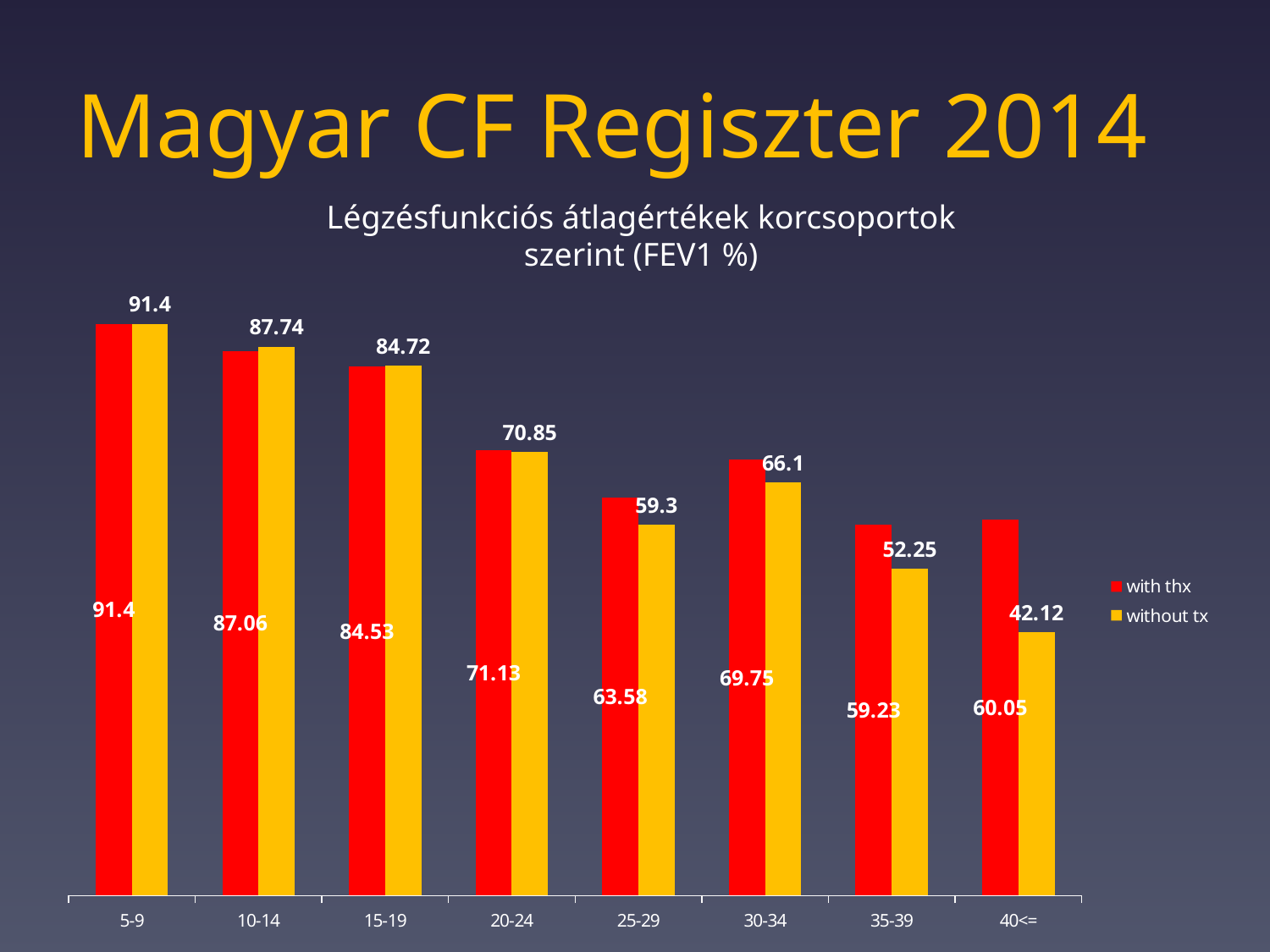
Which age group has the highest 'without tx' value? 5-9 In the 35-39 age group, which is larger: 'with thx' or 'without tx'? with thx Which age group has the lowest 'with thx' value? 35-39 What kind of chart is shown on the slide? bar chart What is the difference between the 'with thx' and 'without tx' values in the 40<= age group? 17.93 What is the value for 'with thx' in the 10-14 age group? 87.06 How many age groups are shown on the x axis? 8 What is the value for 'with thx' in the 25-29 age group? 63.58 What is the value for 'without tx' in the 40<= age group? 42.12 What is the value for 'without tx' in the 30-34 age group? 66.1 How many series does the legend list? 2 Which colour represents the 'without tx' series? yellow